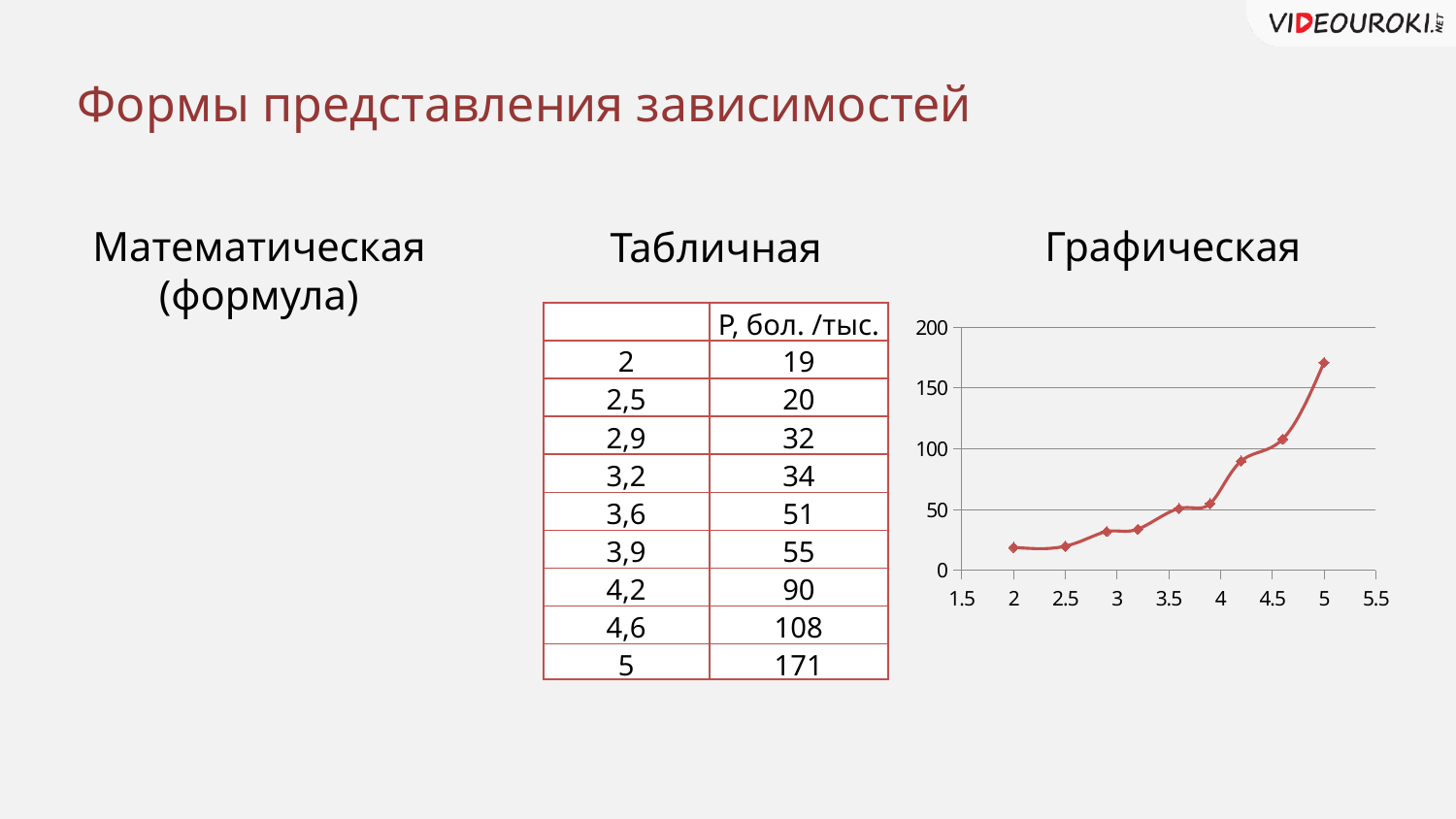
Is the plotted value at x = 2 greater or less than 50? less What kind of chart is shown on the slide? line chart What is the highest tick value shown on the vertical axis of the chart? 200 How many data points are plotted on the line chart? 9 Is the plotted value at x = 4.6 greater or less than 100? greater According to the table on the slide, what is the value of P at x = 5? 171 Do the values on the line chart rise or fall as x increases from 2 to 5? rise According to the table on the slide, what is the difference between P at x = 5 and P at x = 2? 152 Is the plotted value at x = 5 greater or less than 150? greater Which has the larger plotted value, x = 4.6 or x = 4.2? 4.6 At which x value does the line chart reach its highest point? 5 At which x value does the line chart have its lowest point? 2